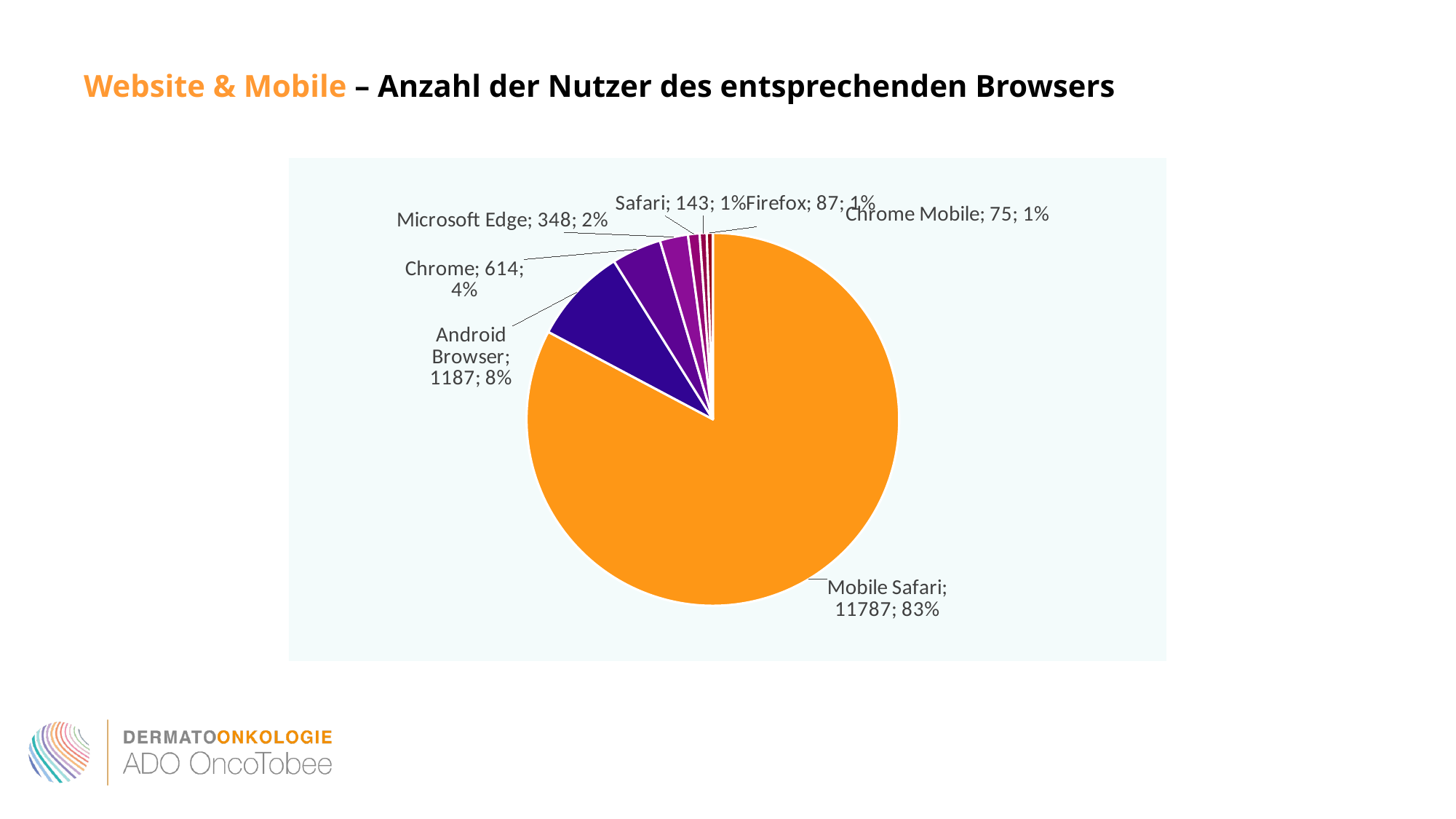
What share of the pie does Android Browser account for? 8% Which has more users, Safari or Firefox? Safari How many browser categories are shown in the pie chart? 7 How many users does the chart show for Firefox? 87 Which browser has the smallest number of users? Chrome Mobile How many users does the chart show for Mobile Safari? 11787 Which browser has the largest number of users? Mobile Safari What is the difference in users between Chrome and Microsoft Edge? 266 What share of the pie does Chrome account for? 4% What kind of chart is shown on the slide? pie chart How many users does the chart show for Microsoft Edge? 348 How many users does the chart show for Android Browser? 1187